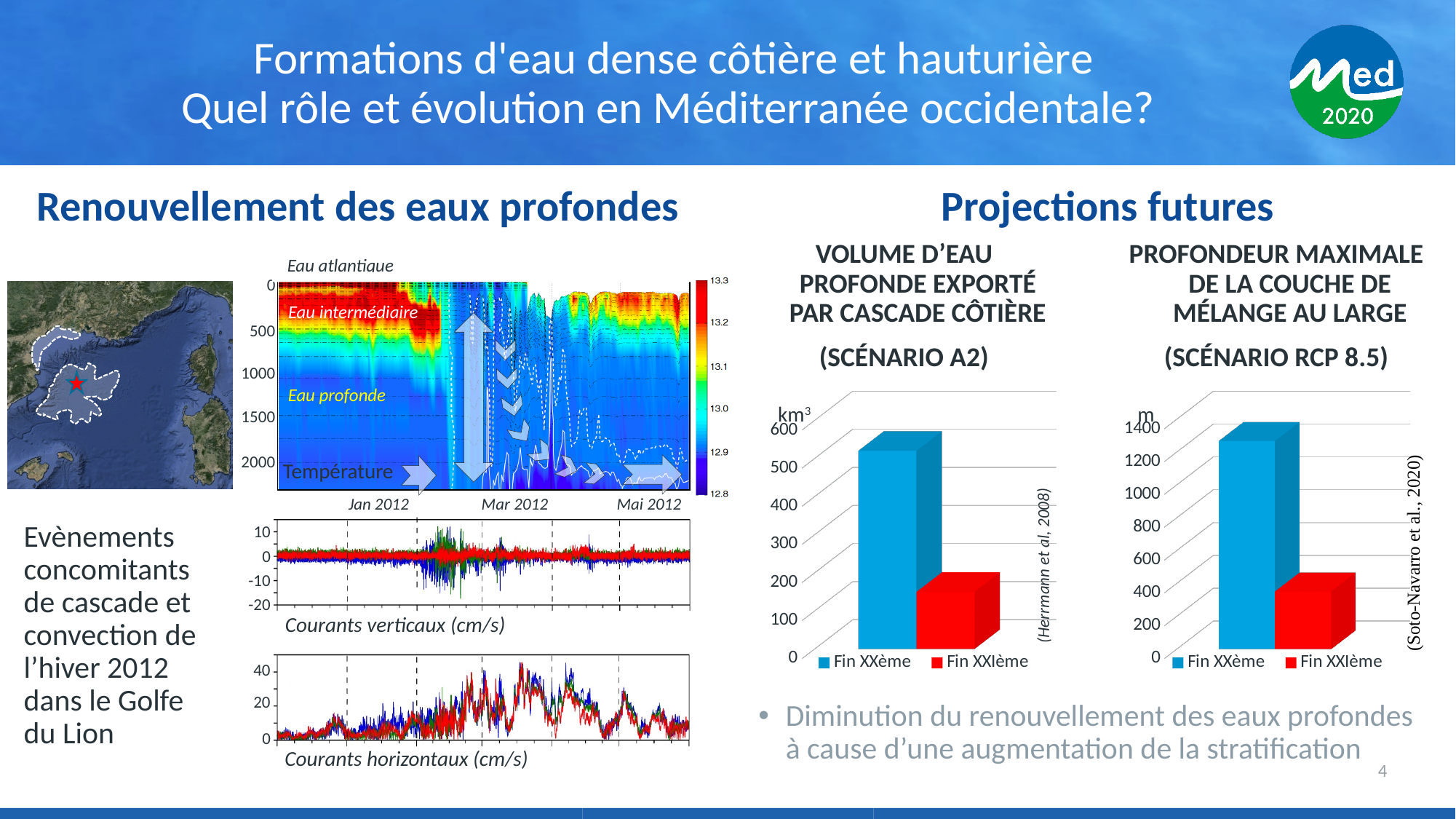
In the 'Volume d'eau profonde exporté par cascade côtière' chart, is the value for Fin XXIème greater or less than 300? less In the 'Profondeur maximale de la couche de mélange au large' chart, is the value for Fin XXème greater or less than 1000? greater What kind of chart is the 'Profondeur maximale de la couche de mélange au large' chart? bar chart In the 'Profondeur maximale de la couche de mélange au large' chart, which colour represents the Fin XXIème series? red What kind of chart is the 'Volume d'eau profonde exporté par cascade côtière' chart? bar chart What unit is shown on the vertical axis of the 'Volume d'eau profonde exporté par cascade côtière' chart? km³ In the 'Volume d'eau profonde exporté par cascade côtière' chart, which series has the higher value, Fin XXème or Fin XXIème? Fin XXème In the 'Volume d'eau profonde exporté par cascade côtière' chart, is the value for Fin XXème greater or less than 400? greater In the 'Profondeur maximale de la couche de mélange au large' chart, what are the two legend entries? Fin XXème and Fin XXIème In the 'Volume d'eau profonde exporté par cascade côtière' chart, how many series does the legend list? 2 In the 'Profondeur maximale de la couche de mélange au large' chart, which series has the lower value? Fin XXIème